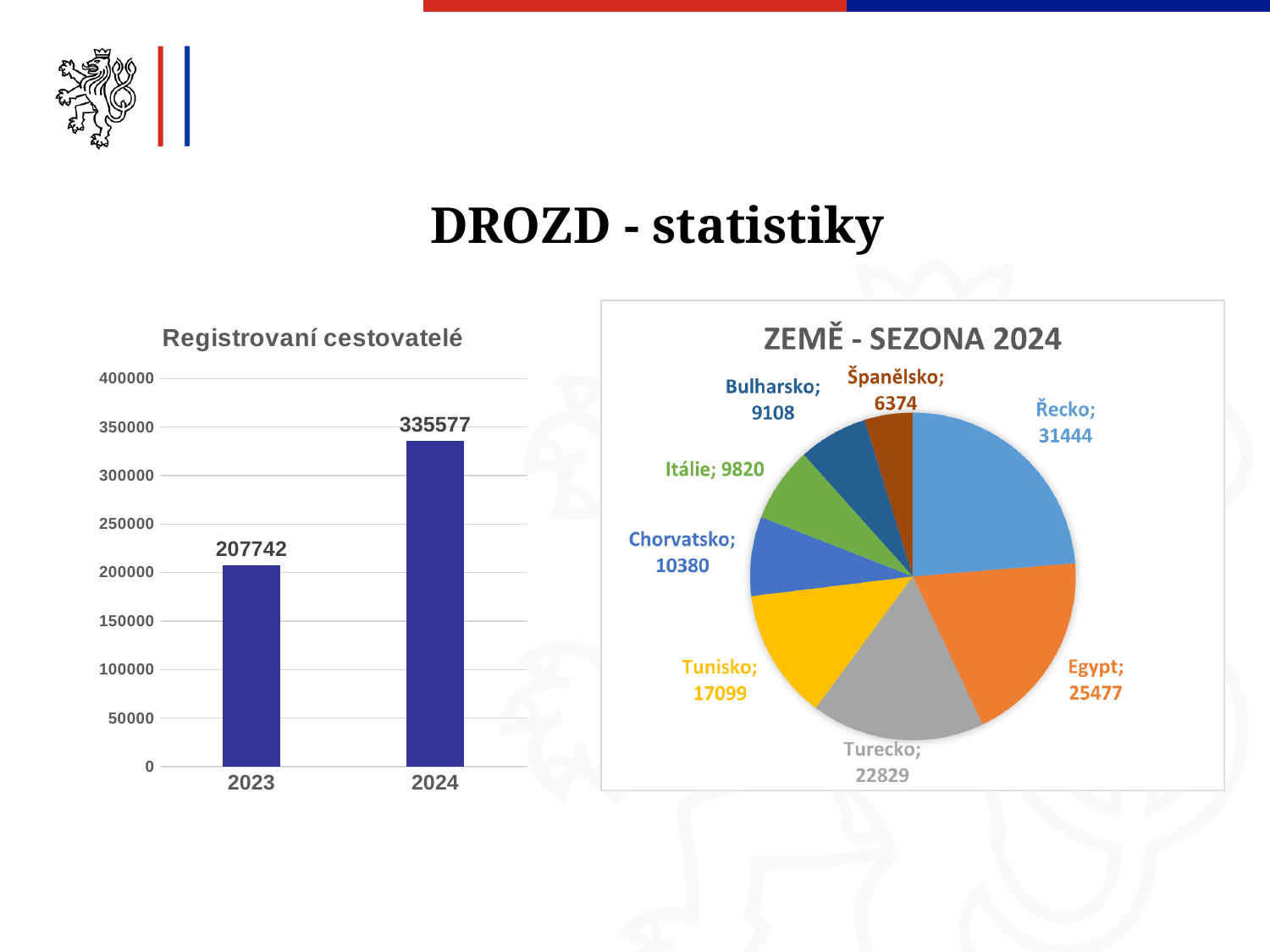
In the chart titled 'ZEMĚ - SEZONA 2024', what is the value for Chorvatsko? 10380 In the chart titled 'Registrovaní cestovatelé', do the values rise or fall from 2023 to 2024? rise In the chart titled 'Registrovaní cestovatelé', what is the difference between the 2024 and 2023 values? 127835 In the chart titled 'Registrovaní cestovatelé', what is the value for 2023? 207742 In the chart titled 'Registrovaní cestovatelé', what is the value for 2024? 335577 What kind of chart is the chart titled 'Registrovaní cestovatelé'? bar chart In the chart titled 'ZEMĚ - SEZONA 2024', which country has the smallest slice? Španělsko In the chart titled 'ZEMĚ - SEZONA 2024', what is the difference between the values for Řecko and Egypt? 5967 In the chart titled 'ZEMĚ - SEZONA 2024', how many countries are shown? 8 In the chart titled 'ZEMĚ - SEZONA 2024', which country has the largest slice? Řecko In the chart titled 'ZEMĚ - SEZONA 2024', what is the value for Turecko? 22829 In the chart titled 'ZEMĚ - SEZONA 2024', which is larger, Tunisko or Itálie? Tunisko